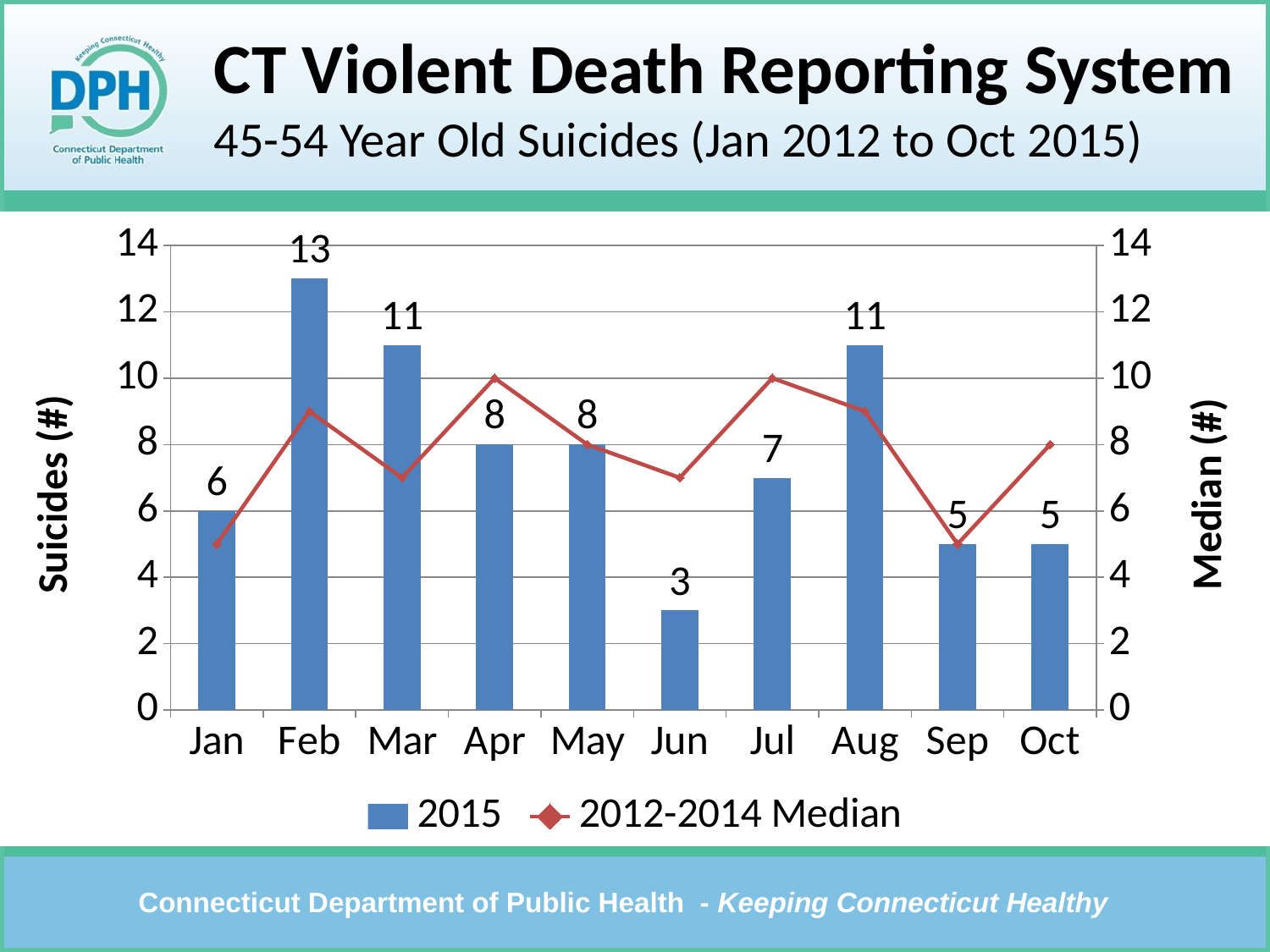
Which month has the highest 2015 value? Feb What is the label of the left vertical axis? Suicides (#) How many series does the legend list? 2 Is the 2012-2014 Median value for Feb greater or less than 8? greater Which is larger, the 2015 value for Jul or the 2015 value for Sep? Jul Is the 2012-2014 Median value for Jan greater or less than 6? less What is the 2015 value for Feb? 13 How many months are shown on the x axis? 10 What is the 2015 value for Jun? 3 Which month has the lowest 2015 value? Jun What is the difference between the 2015 values for Feb and Jan? 7 What kind of chart is used for the 2015 series? bar chart